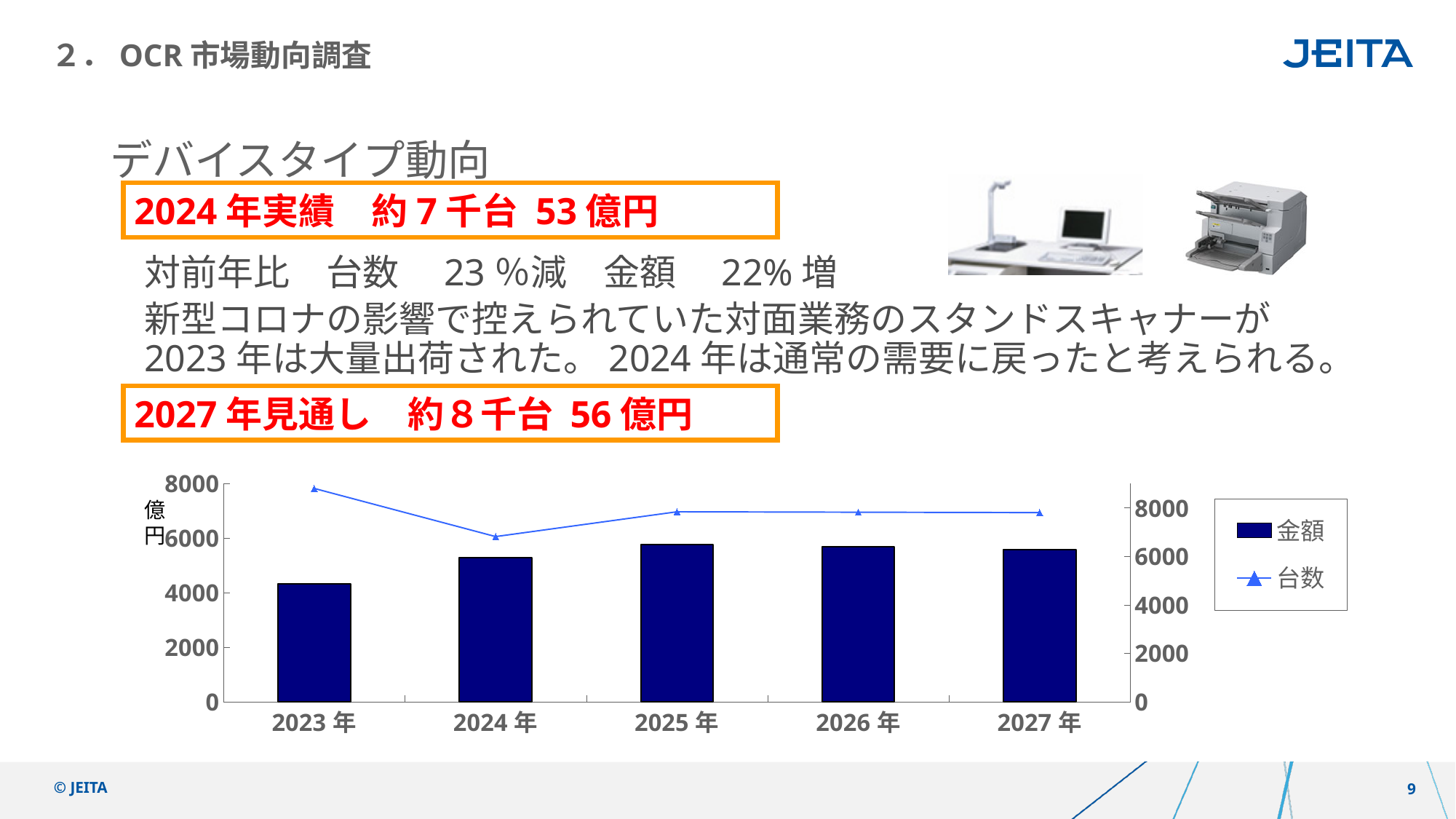
Which series are listed in the chart legend? 金額 and 台数 Is the 金額 bar for 2024年 greater or less than 4000? greater Does the 台数 line rise or fall from 2023年 to 2024年? fall Which is larger, the 金額 bar for 2023年 or for 2024年? 2024年 Which year has the lowest 金額 bar? 2023年 How many series does the chart legend list? 2 How many years are shown on the x axis of the chart? 5 Which year has the lowest 台数 point on the line? 2024年 Is the 台数 value for 2023年 greater or less than 6000 on the right axis? greater Is the 金額 bar for 2023年 greater or less than 6000? less Which year has the highest 台数 point on the line? 2023年 What kind of chart is shown on the slide? A bar chart combined with a line chart